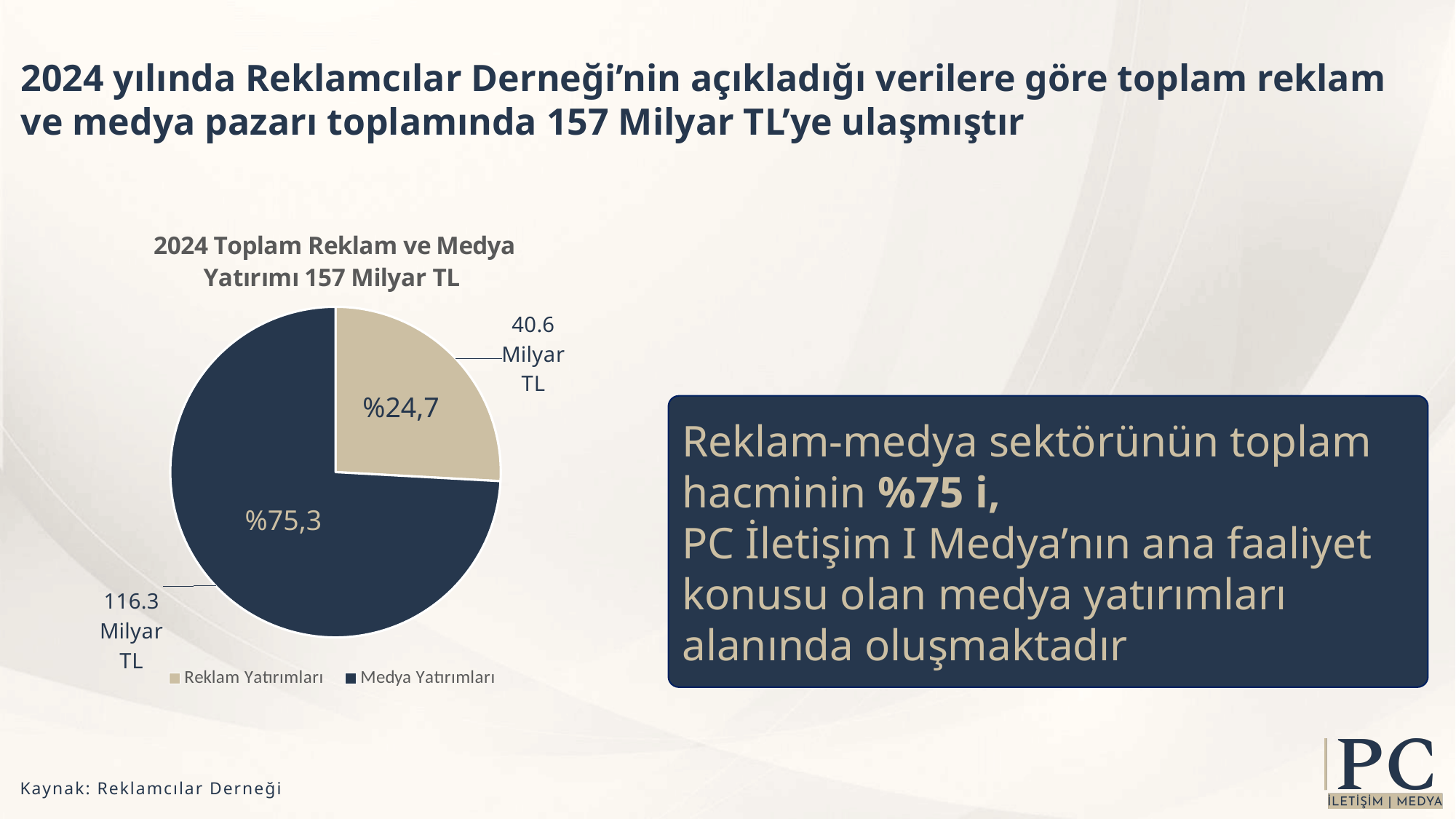
How many slices does the pie chart have? 2 What is the value for Reklam Yatırımları in the pie chart? 40.6 Milyar TL What percentage share of the pie does Medya Yatırımları have? %75,3 What is the value for Medya Yatırımları in the pie chart? 116.3 Milyar TL Which slice of the pie chart is the largest? Medya Yatırımları What kind of chart is shown on the slide? Pie chart Which is larger in the pie chart, Reklam Yatırımları or Medya Yatırımları? Medya Yatırımları What percentage share of the pie does Reklam Yatırımları have? %24,7 What is the title of the pie chart? 2024 Toplam Reklam ve Medya Yatırımı 157 Milyar TL Which slice of the pie chart is the smallest? Reklam Yatırımları What is the difference in Milyar TL between Medya Yatırımları and Reklam Yatırımları? 75.7 Milyar TL Which colour represents Medya Yatırımları in the pie chart? Dark navy blue